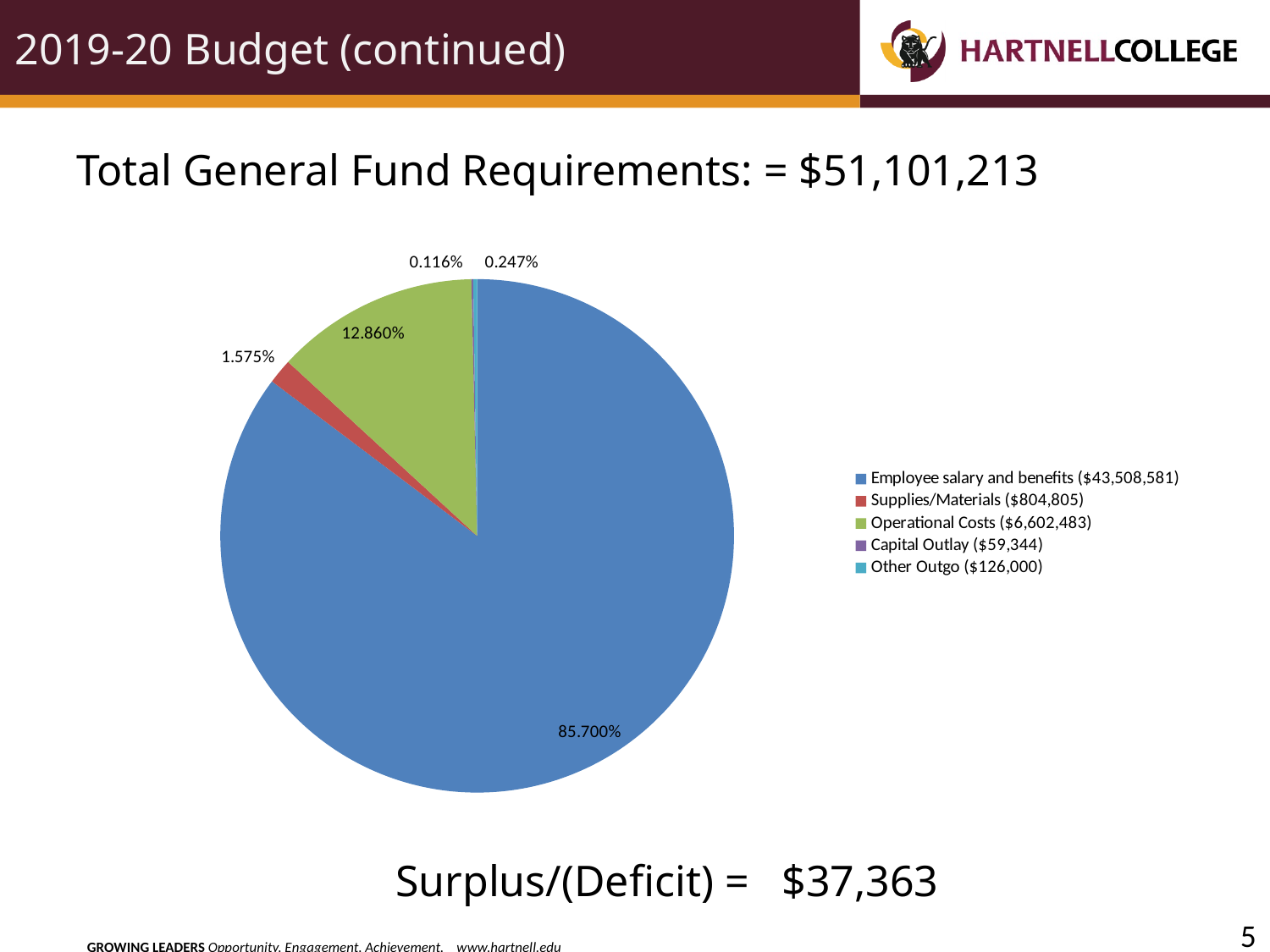
What kind of chart is shown on the slide? pie chart How many entries does the legend of the pie chart list? 5 What share of the pie does Employee salary and benefits represent? 85.700% Which category has the largest slice of the pie? Employee salary and benefits What dollar amount does the legend give for Operational Costs? $6,602,483 What is the difference in percentage points between the Employee salary and benefits share and the Operational Costs share? 72.840% Which category has the smallest slice of the pie? Capital Outlay How many slices does the pie chart have? 5 What share of the pie does Capital Outlay represent? 0.116% Which is larger, the share for Supplies/Materials or the share for Other Outgo? Supplies/Materials What share of the pie does Supplies/Materials represent? 1.575%